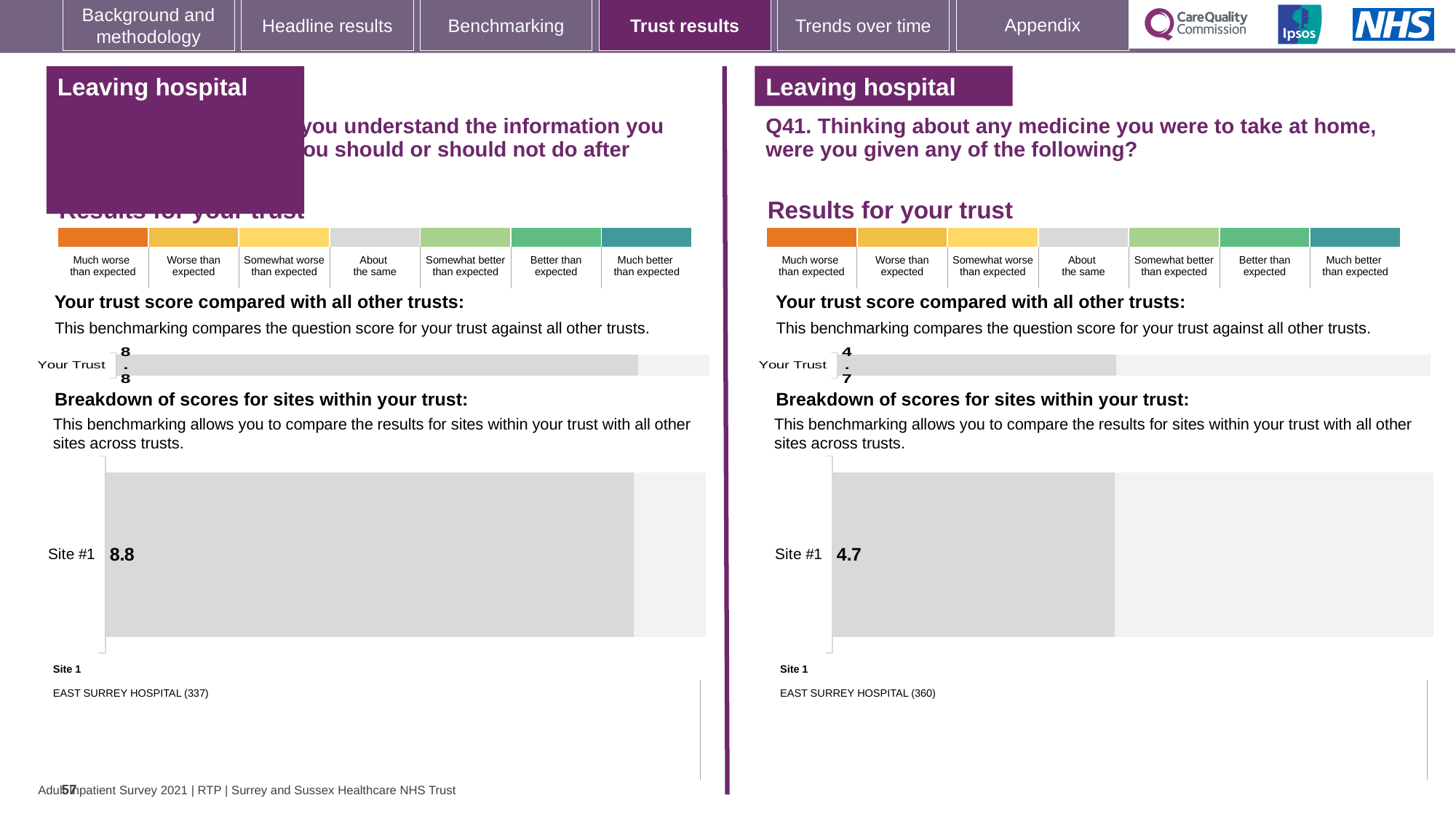
Which is larger: the Your Trust score on the left-hand chart or the Your Trust score on the right-hand chart? The left-hand chart (8.8) In the right-hand breakdown of scores for sites (Q41), what is the score for Site #1? 4.7 What number appears in parentheses after EAST SURREY HOSPITAL beneath the right-hand site breakdown chart? 360 In the left-hand breakdown of scores for sites, what is the score for Site #1? 8.8 How many sites are shown in the left-hand breakdown of scores for sites within your trust? 1 Which hospital is listed as Site 1 beneath the left-hand site breakdown chart? EAST SURREY HOSPITAL (337) On the right-hand chart (Q41), what is the score shown for Your Trust? 4.7 On the left-hand chart, what is the score shown for Your Trust? 8.8 How many sites are shown in the right-hand breakdown of scores for sites within your trust? 1 What is the difference between the Site #1 score on the left-hand chart and the Site #1 score on the right-hand chart? 4.1 What type of chart is used to show the Site #1 score on the right-hand side? Bar chart